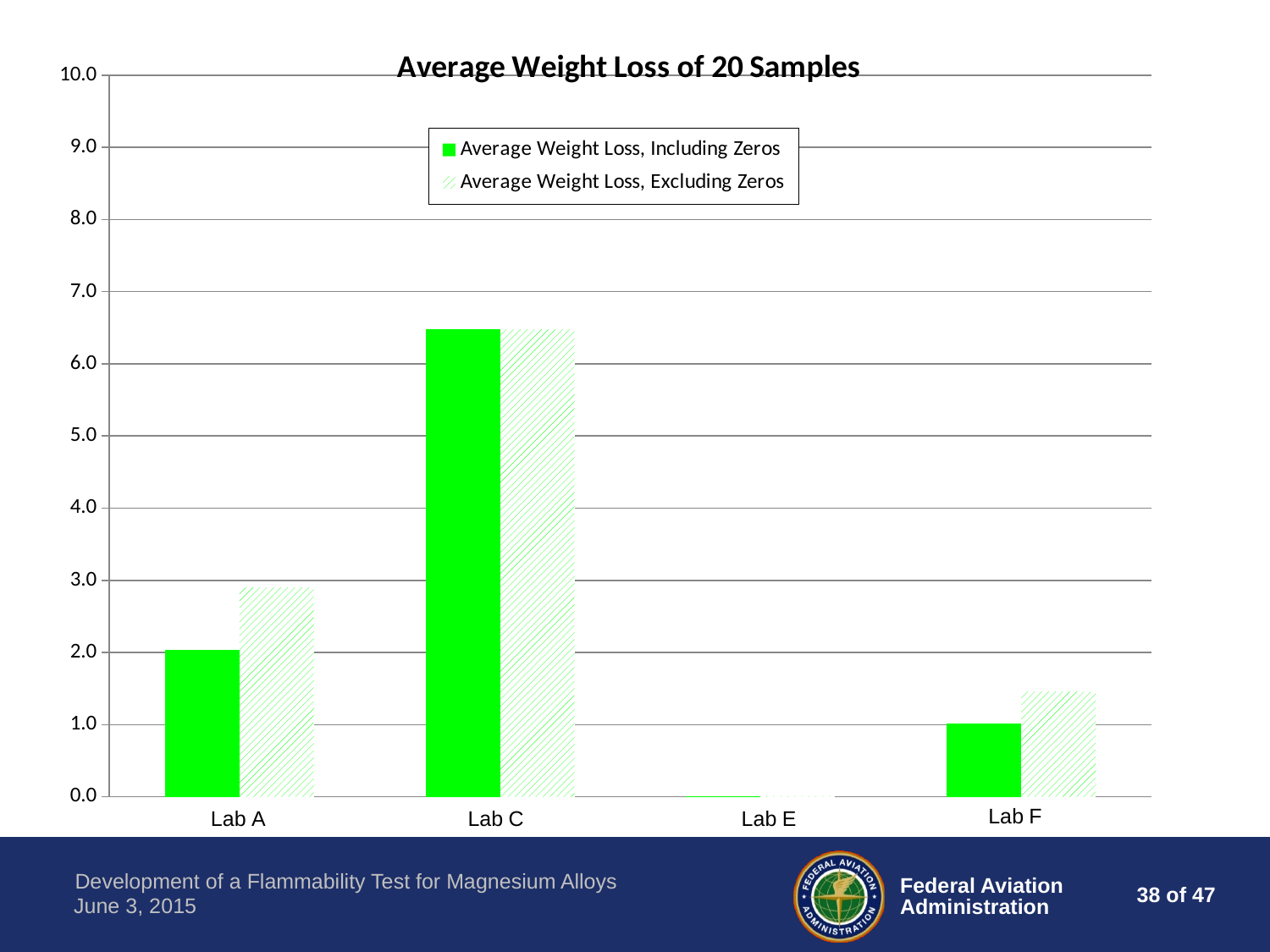
Which lab has the lowest Average Weight Loss, Excluding Zeros? Lab E Is the Average Weight Loss, Including Zeros for Lab C greater or less than 6.0? greater Which is larger for Lab A: Average Weight Loss, Including Zeros or Average Weight Loss, Excluding Zeros? Average Weight Loss, Excluding Zeros Which lab has the larger Average Weight Loss, Including Zeros: Lab A or Lab F? Lab A Which series is drawn with the hatched pattern in the chart? Average Weight Loss, Excluding Zeros Is the Average Weight Loss, Excluding Zeros for Lab A greater or less than 3.0? less How many labs are shown on the x axis of the chart? 4 Is the Average Weight Loss, Excluding Zeros for Lab F greater or less than 1.0? greater How many series does the chart's legend list? 2 Which lab has the highest Average Weight Loss, Including Zeros? Lab C What is the title of the chart? Average Weight Loss of 20 Samples What kind of chart is shown on the slide? Bar chart